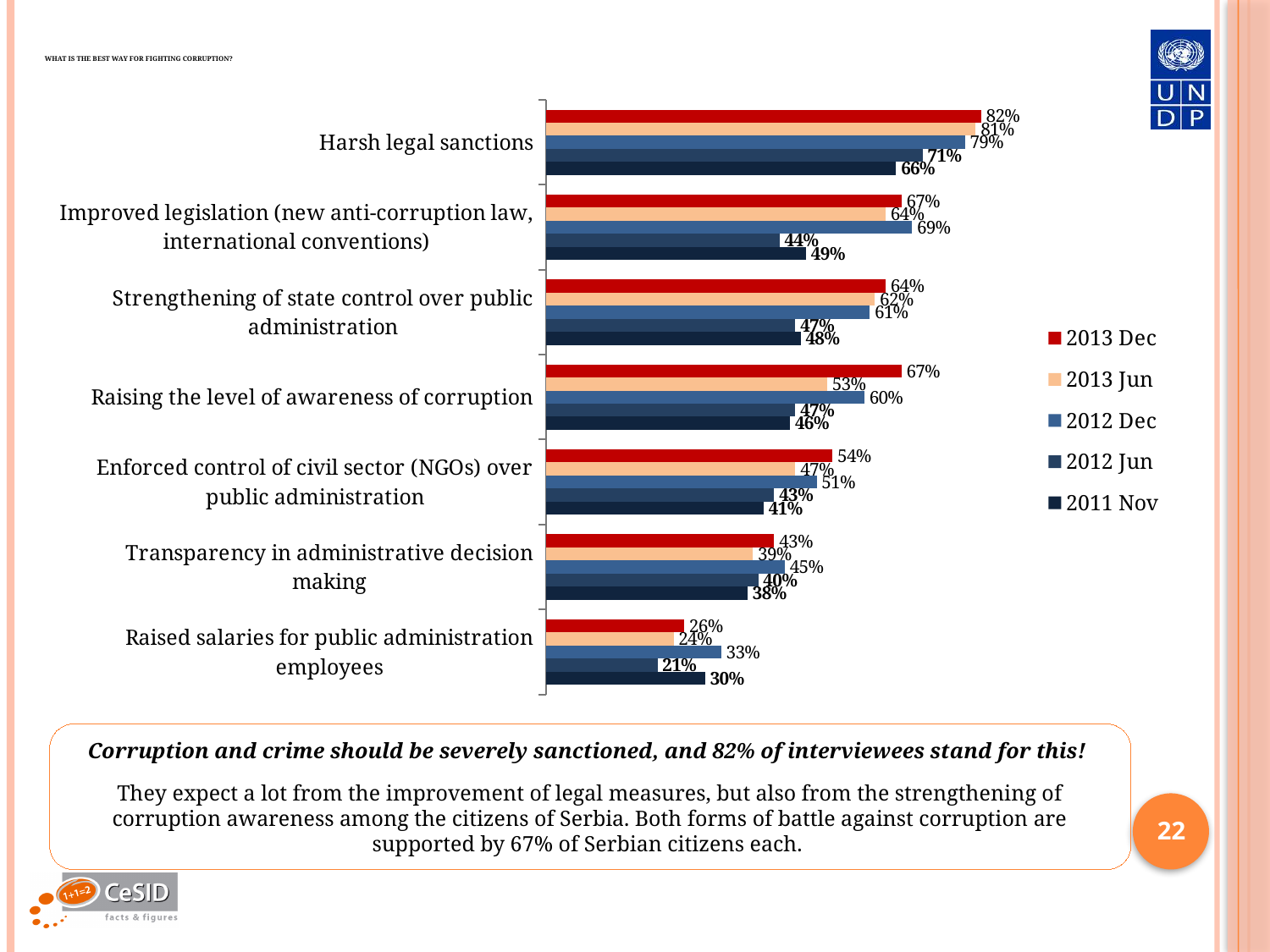
What kind of chart is shown on the slide? bar chart Which series is shown in red in the legend? 2013 Dec What is the difference between the 2013 Dec and 2013 Jun values for Raising the level of awareness of corruption? 14% What is the 2013 Dec value for Harsh legal sanctions? 82% For Raising the level of awareness of corruption, which is larger: the 2013 Jun value or the 2012 Dec value? 2012 Dec How many categories are shown on the chart? 7 Which category has the lowest 2012 Dec value? Raised salaries for public administration employees What is the 2012 Jun value for Improved legislation (new anti-corruption law, international conventions)? 44% How many series does the legend list? 5 What is the difference between the 2013 Dec and 2011 Nov values for Harsh legal sanctions? 16% What is the 2011 Nov value for Raised salaries for public administration employees? 30% Which category has the highest 2013 Dec value? Harsh legal sanctions